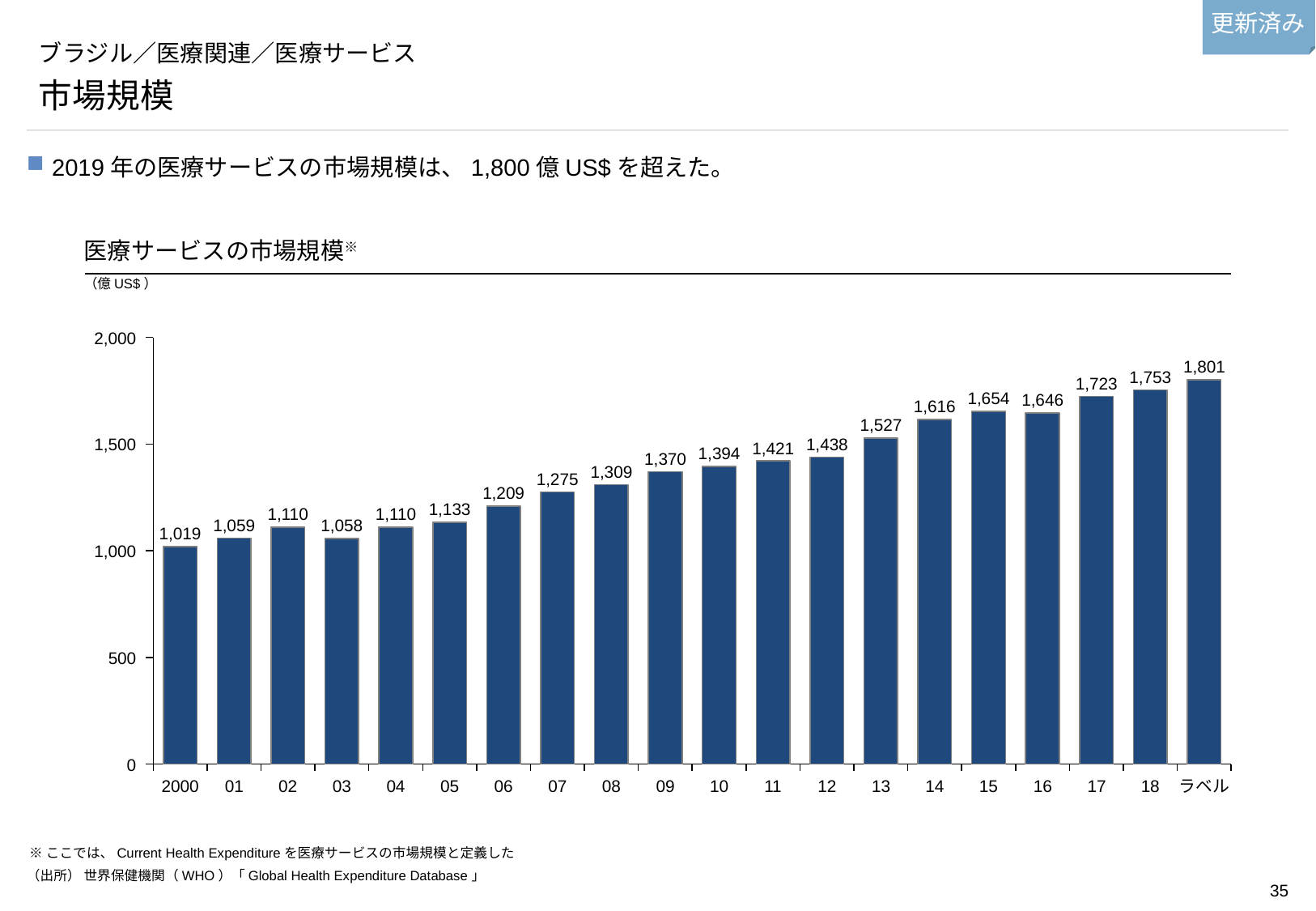
What is the difference between the values for 18 and 17? 30 What is the value for 18 in the chart? 1,753 What unit is shown for the chart's values? 億US$ What is the highest value shown in the chart? 1,801 Which category has the lowest value in the chart? 2000 Which is larger, the value for 02 or the value for 03? 02 What is the value for 13 in the chart? 1,527 What kind of chart is shown on the slide? bar chart What is the value for 2000 in the chart? 1,019 How many bars are plotted in the chart? 20 What is the difference between the values for 18 and 2000? 734 What is the value of the last bar, labelled ラベル? 1,801